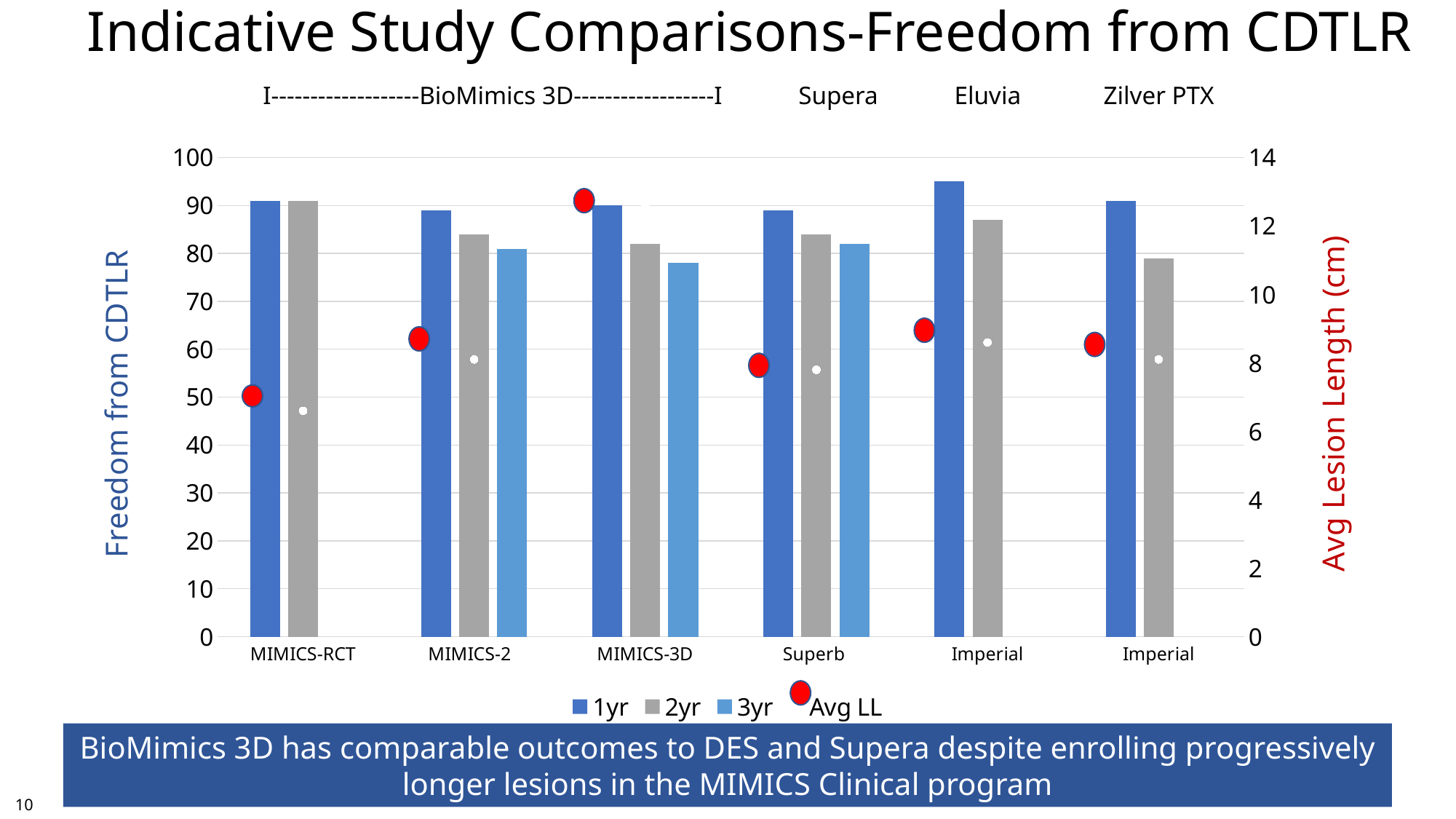
How many categories have a 3yr bar? 3 How many series does the legend list? 4 Does the Avg LL value rise or fall from MIMICS-RCT to MIMICS-3D? rise How many study categories are shown along the x axis? 6 What is the title of the right-hand vertical axis? Avg Lesion Length (cm) Which category has the highest 1yr value? Imperial (first) Is the Avg LL value for MIMICS-3D greater or less than 12? greater Which category has the highest Avg LL value? MIMICS-3D Which category has the lowest Avg LL value? MIMICS-RCT What kind of chart is shown on the slide? bar chart For MIMICS-3D, which is larger, the 1yr value or the 2yr value? 1yr Is the 3yr value for MIMICS-2 greater or less than 90? less